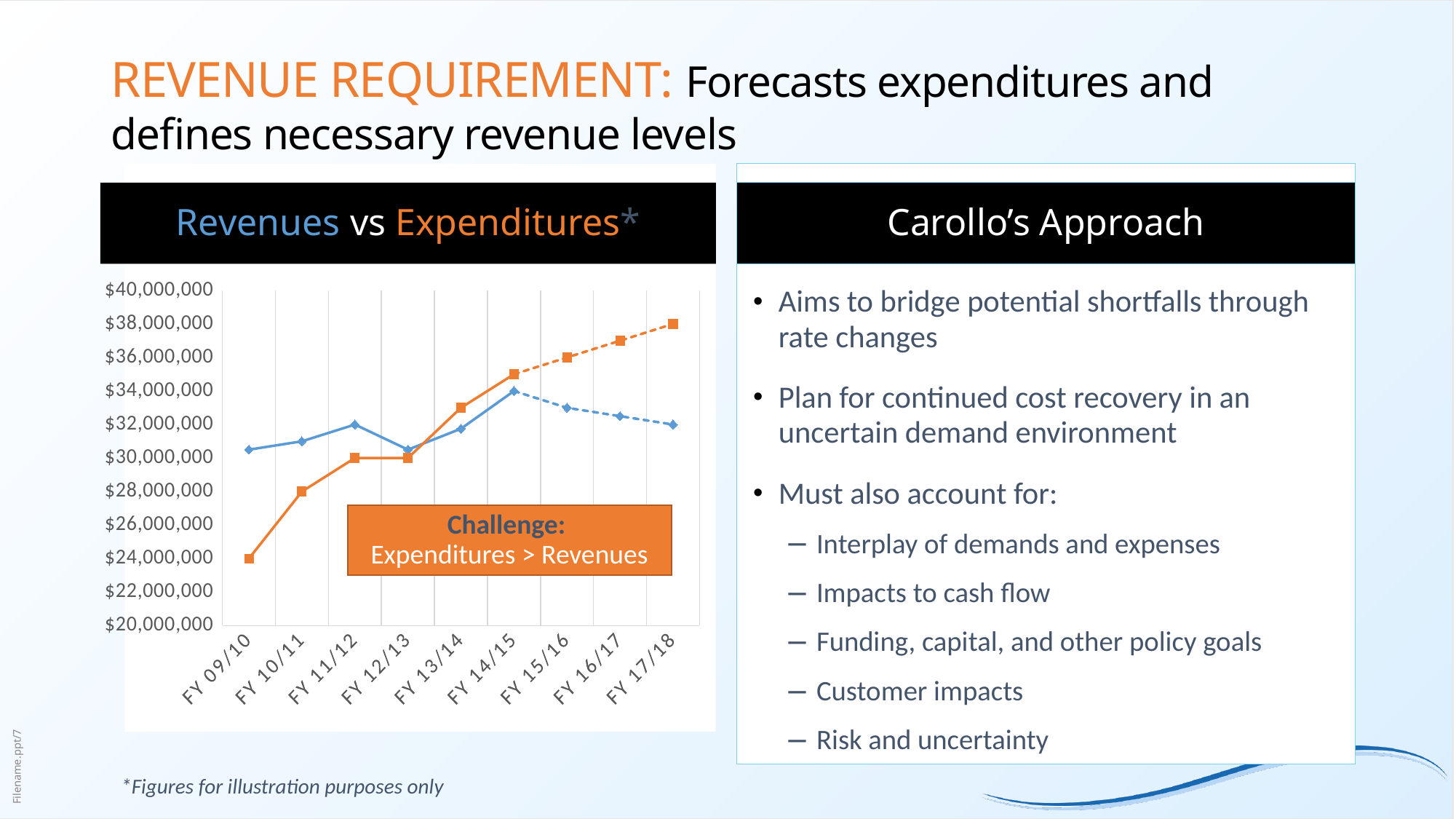
Is the Revenues value for FY 17/18 greater or less than $34,000,000? less How many fiscal years are plotted on the x axis of the Revenues vs Expenditures chart? 9 Is the Revenues value for FY 09/10 greater or less than $28,000,000? greater What text appears in the orange callout box inside the chart? Challenge: Expenditures > Revenues Is the Expenditures value for FY 09/10 greater or less than $26,000,000? less In FY 17/18, which is larger, Revenues or Expenditures? Expenditures Which fiscal year has the lowest Expenditures value? FY 09/10 Do the Expenditures values rise or fall from FY 09/10 to FY 17/18? Rise What kind of chart is shown under the title "Revenues vs Expenditures*"? Line chart In FY 09/10, which is larger, Revenues or Expenditures? Revenues